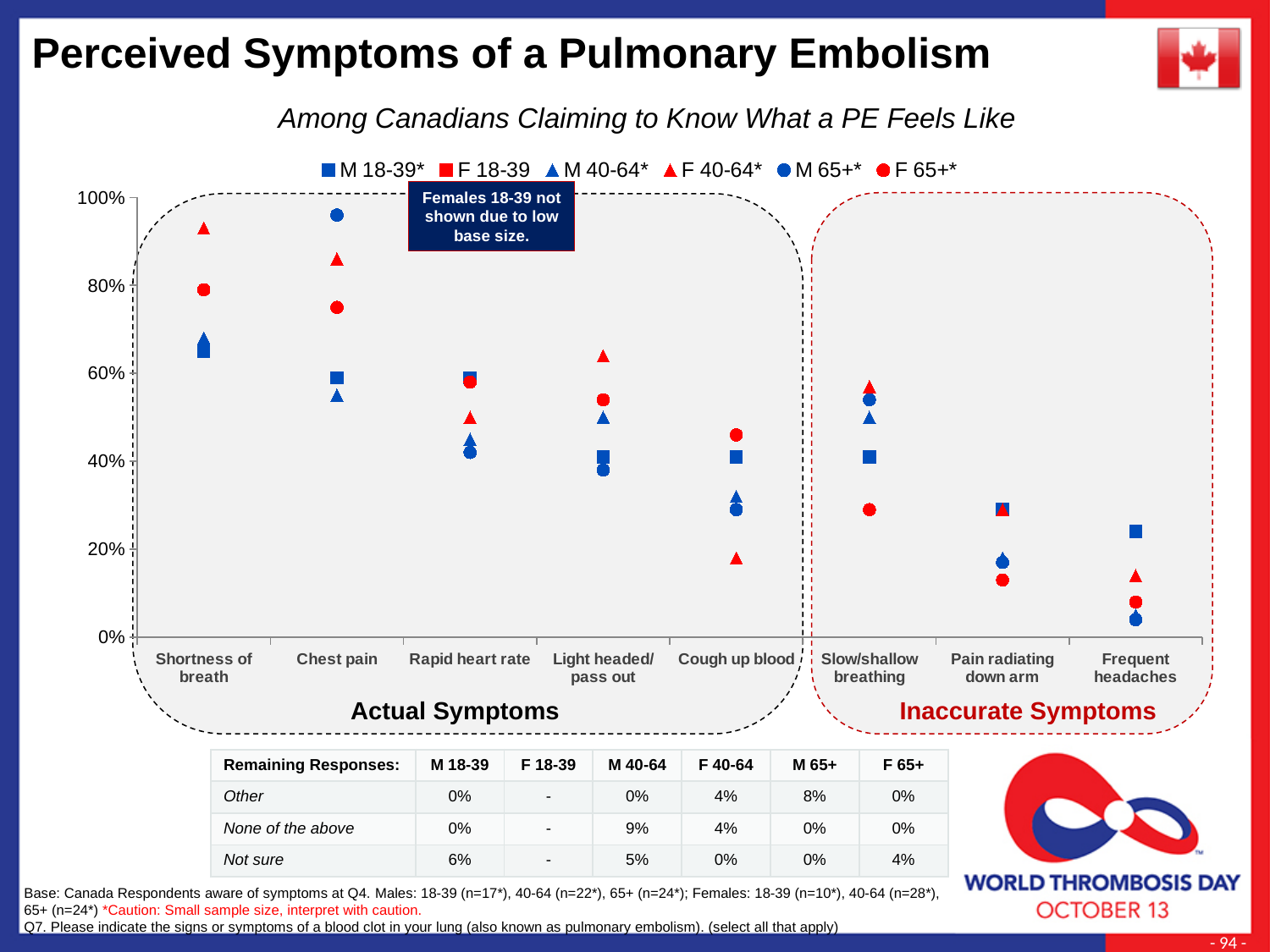
Which symptom has the lowest value for the M 65+ series? Frequent headaches How many series does the chart legend list? 6 What kind of chart is shown on the slide? Scatter (dot) chart Which symptom has the highest value for the M 65+ series? Chest pain Which series is not shown on the chart due to low base size? F 18-39 Is the value for M 18-39 on Frequent headaches greater or less than 20%? greater Is the value for F 40-64 on Shortness of breath greater or less than 80%? greater For Cough up blood, which is larger: the F 65+ value or the F 40-64 value? F 65+ How many symptom categories are plotted along the x axis? 8 Is the value for F 40-64 on Cough up blood greater or less than 20%? less For Shortness of breath, which is larger: the F 65+ value or the M 18-39 value? F 65+